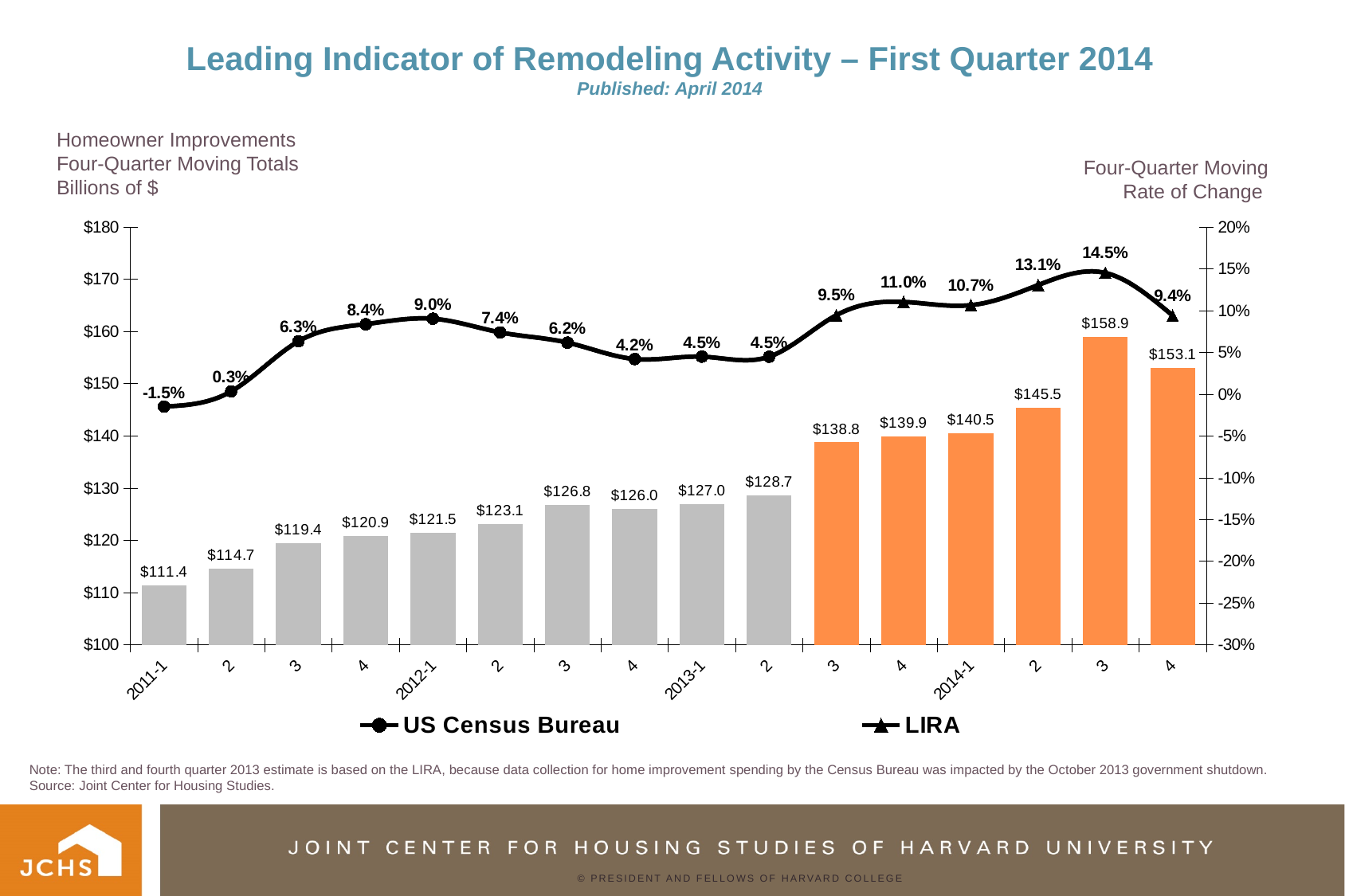
Which quarter has the highest four-quarter moving rate of change on the line? 2014-3 Which quarter has the highest four-quarter moving total bar? 2014-3 How many quarters are plotted along the x axis? 16 What is the four-quarter moving rate of change shown for 2014-2? 13.1% Which has the larger four-quarter moving total, 2012-3 or 2012-4? 2012-3 What is the difference between the four-quarter moving totals for 2014-3 and 2014-4? $5.8 What kind of chart is shown on the slide? Combination bar and line chart Which quarter has the lowest four-quarter moving total bar? 2011-1 How many series does the legend list? 2 What is the four-quarter moving total shown for 2014-3? $158.9 What are the two entries in the chart legend? US Census Bureau and LIRA What is the lowest rate of change value labeled on the line? -1.5%